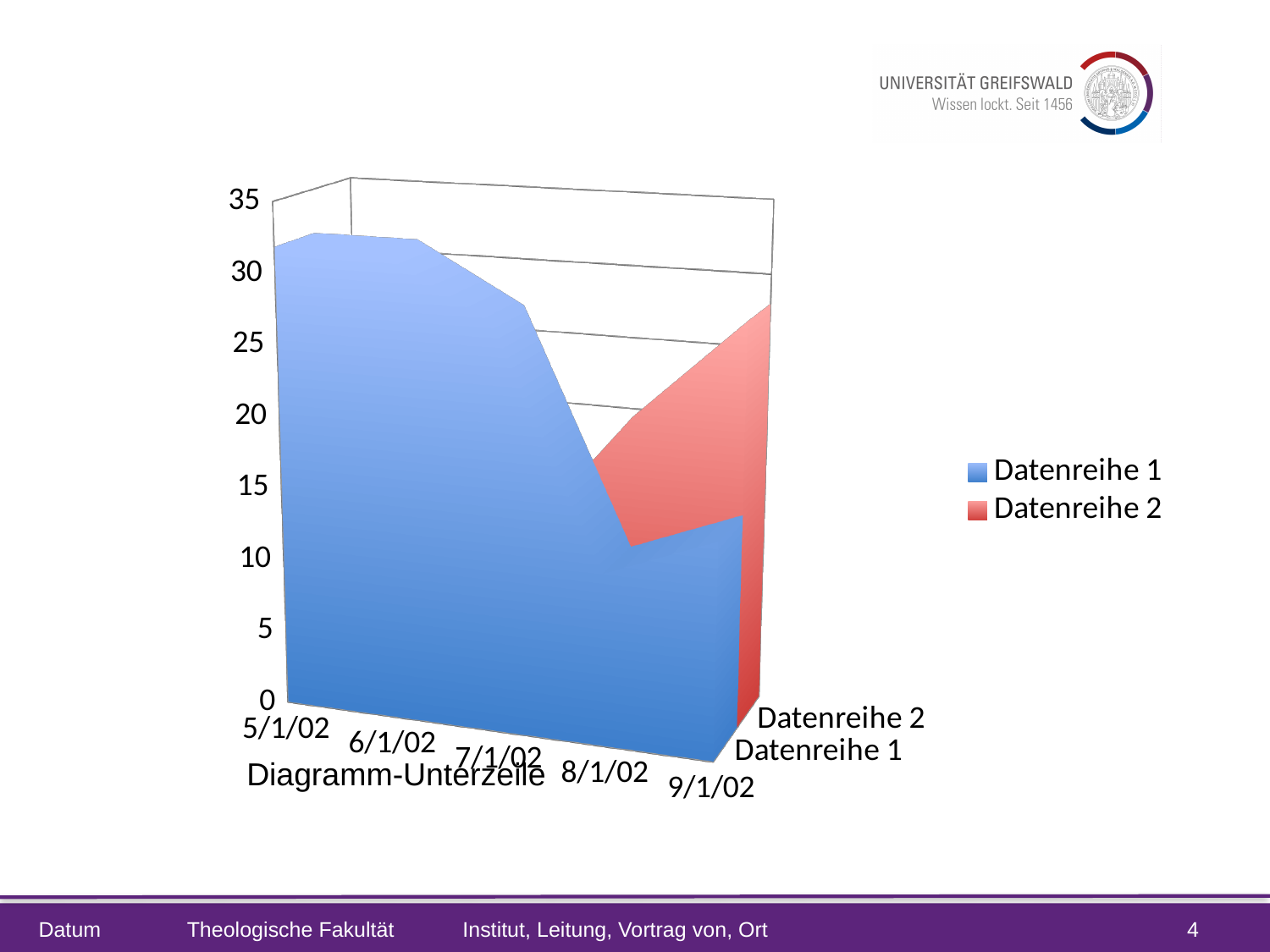
Is the value for Datenreihe 1 at 7/1/02 greater or less than 25? greater Is the value for Datenreihe 1 at 8/1/02 greater or less than 15? less How many series does the legend list? 2 Is the value for Datenreihe 1 at 9/1/02 greater or less than 20? less Which series is shown in red? Datenreihe 2 Does Datenreihe 1 overall rise or fall from 5/1/02 to 9/1/02? fall Which is larger for Datenreihe 1: the value at 5/1/02 or the value at 8/1/02? 5/1/02 What text appears as the axis title below the x axis? Diagramm-Unterzeile How many dates are shown along the x axis? 5 What kind of chart is shown on the slide? Area chart